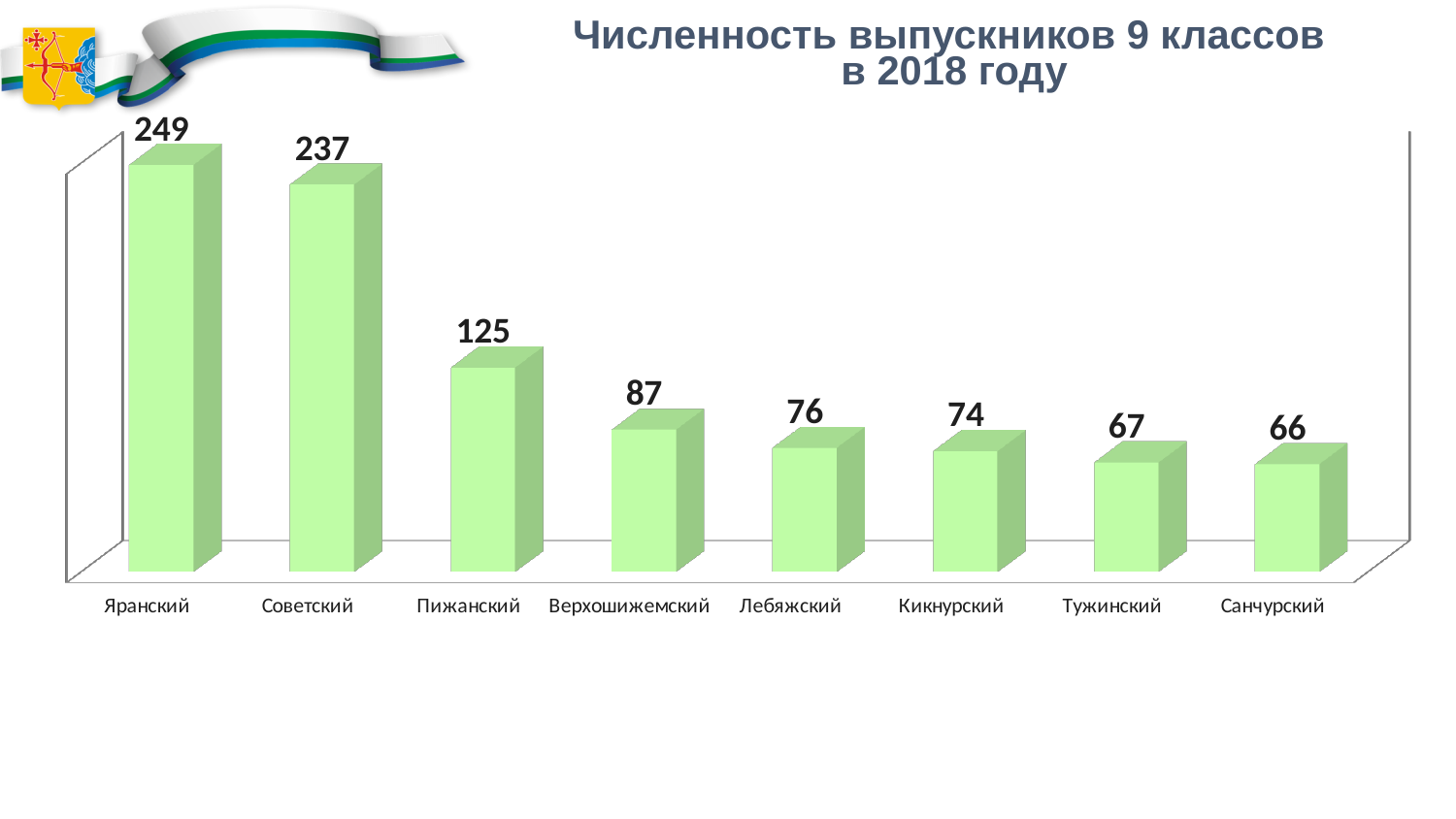
What is the difference between the values for Пижанский and Верхошижемский? 38 Which is larger, the value for Лебяжский or the value for Тужинский? Лебяжский Do the values rise or fall from left to right along the x axis? fall Which category has the highest value? Яранский What is the value for Пижанский? 125 Which category has the lowest value? Санчурский How many categories are shown on the chart? 8 What is the value for Кикнурский? 74 What kind of chart is shown on the slide? bar chart What is the difference between the values for Яранский and Советский? 12 What is the title of the chart? Численность выпускников 9 классов в 2018 году What is the value for Яранский? 249